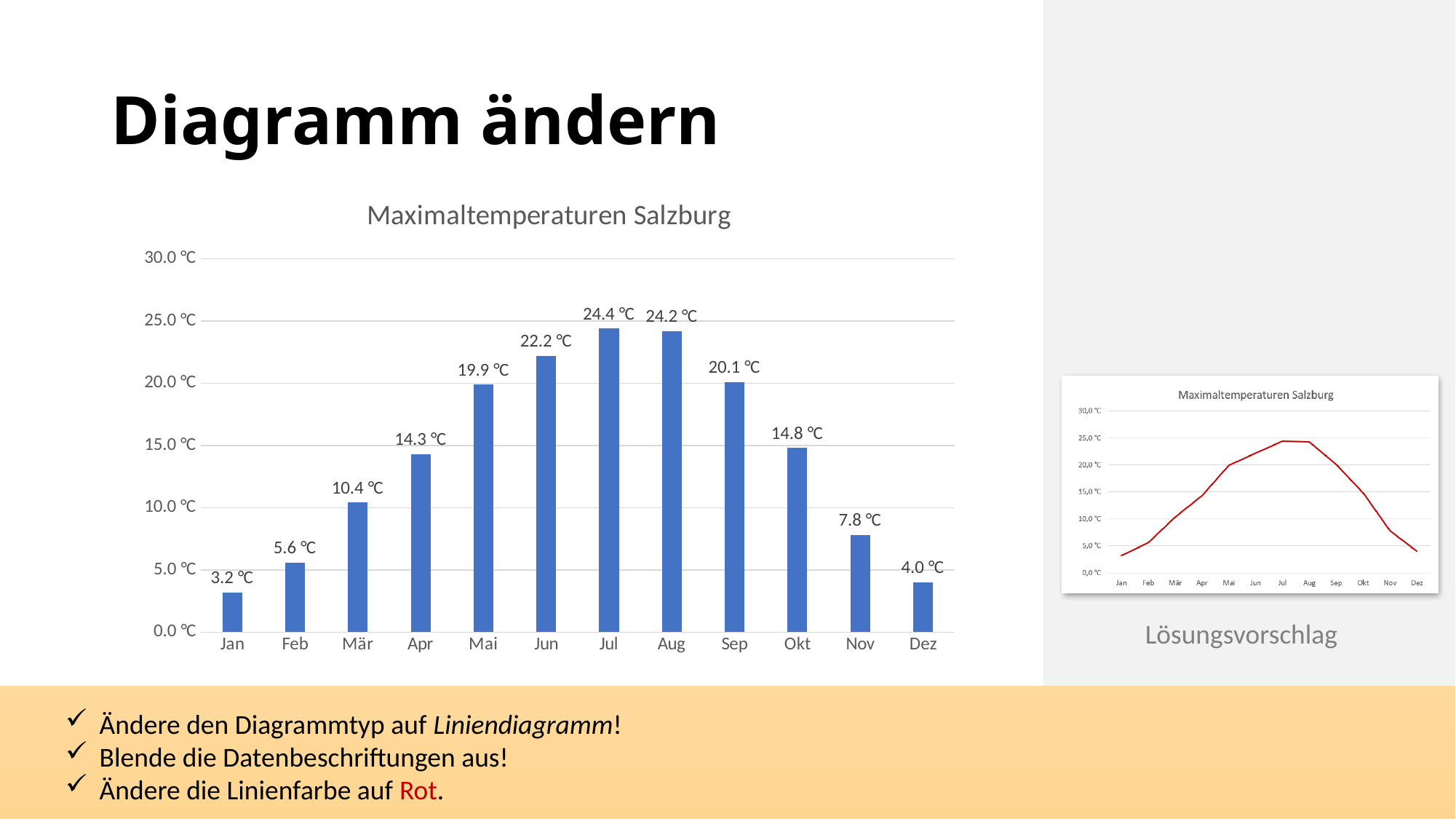
On the large bar chart on the left, what is the value for Jul? 24.4 °C On the large bar chart on the left, what is the difference between the values for Aug and Sep? 4.1 °C What kind of chart is the small chart on the right under the heading Lösungsvorschlag? line chart How many months are shown on the x axis of the large bar chart on the left? 12 What is the title of the large bar chart on the left? Maximaltemperaturen Salzburg On the large bar chart on the left, is the value for Mai greater or less than 15.0 °C? greater On the large bar chart on the left, which is larger, the value for Mär or the value for Nov? Mär On the large bar chart on the left, which month has the lowest value? Jan On the large bar chart on the left, which month has the highest value? Jul What kind of chart is the large chart on the left of the slide? bar chart On the large bar chart on the left, what is the value for Okt? 14.8 °C On the large bar chart on the left, what is the value for Jan? 3.2 °C